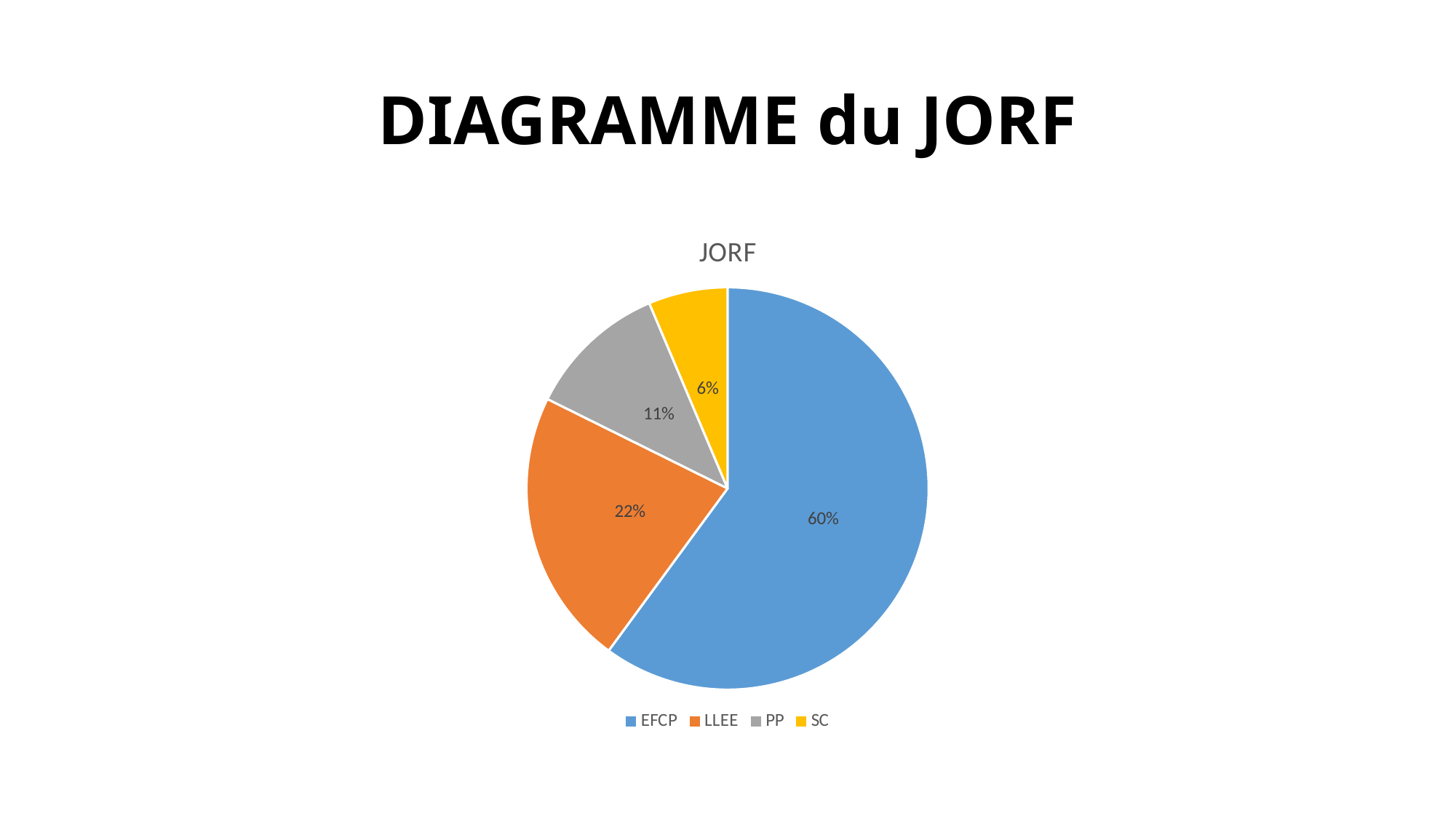
What share of the pie does PP have? 11% What kind of chart is shown on the slide? pie chart How many slices does the pie chart have? 4 Which is larger, the PP slice or the SC slice? PP What share of the pie does SC have? 6% What is the title of the chart? JORF Which category has the smallest slice of the pie? SC What is the difference between the EFCP share and the LLEE share? 38% What share of the pie does LLEE have? 22% Which category has the largest slice of the pie? EFCP Which colour represents LLEE in the legend? orange